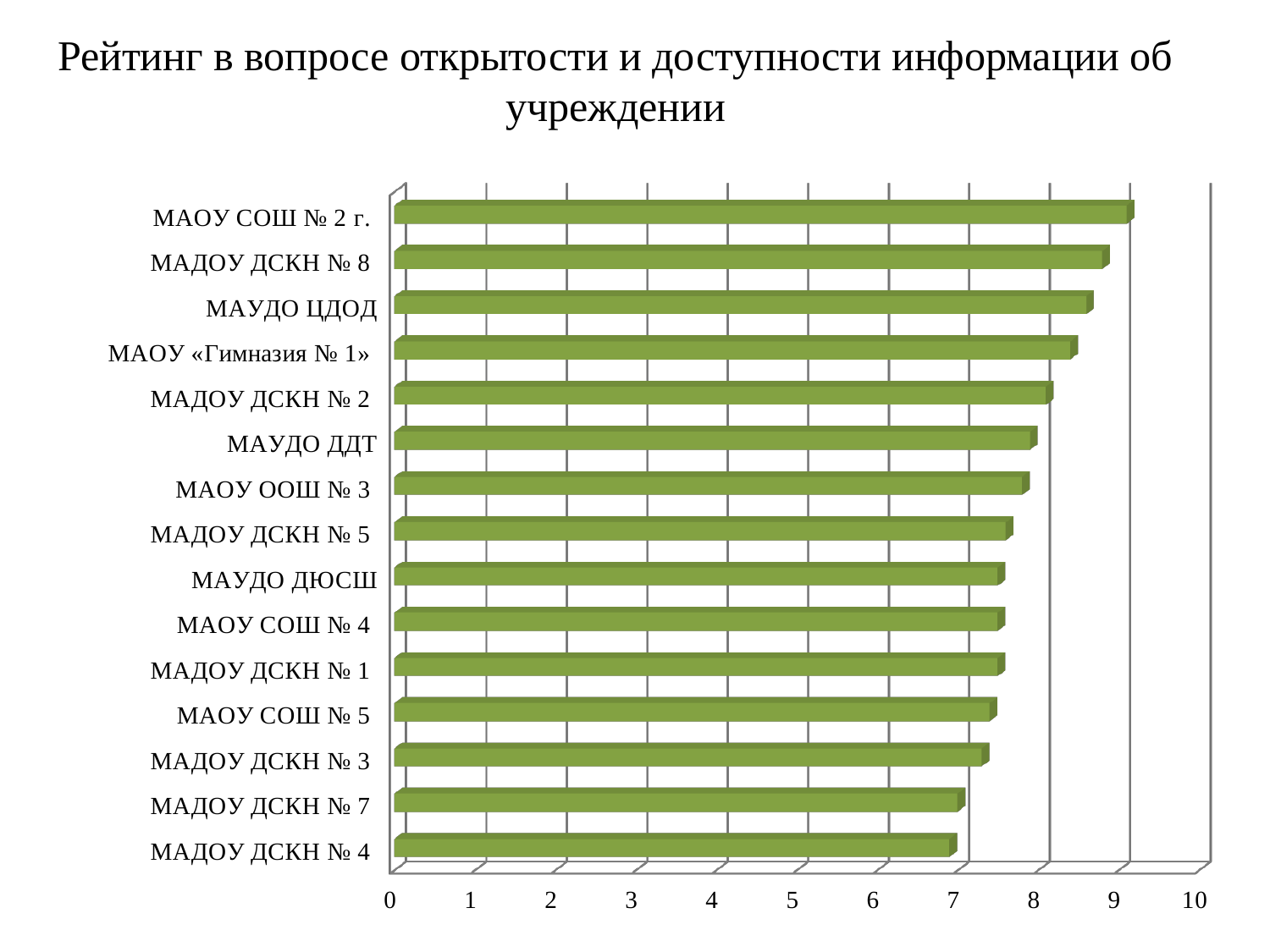
Which has the larger value, МАДОУ ДСКН № 8 or МАДОУ ДСКН № 3? МАДОУ ДСКН № 8 Is the value for МАОУ СОШ № 2 г. greater or less than 8? greater Do the bar lengths increase or decrease going from the top category to the bottom category? decrease Is the value for МАДОУ ДСКН № 8 greater or less than 8? greater What kind of chart is shown on the slide? bar chart How many institutions (categories) are plotted in the chart? 15 Is the value for МАУДО ДДТ greater or less than 7? greater What is the title of the slide's chart? Рейтинг в вопросе открытости и доступности информации об учреждении Which has the larger value, МАУДО ЦДОД or МАУДО ДДТ? МАУДО ЦДОД Which institution has the highest rating in the chart? МАОУ СОШ № 2 г.